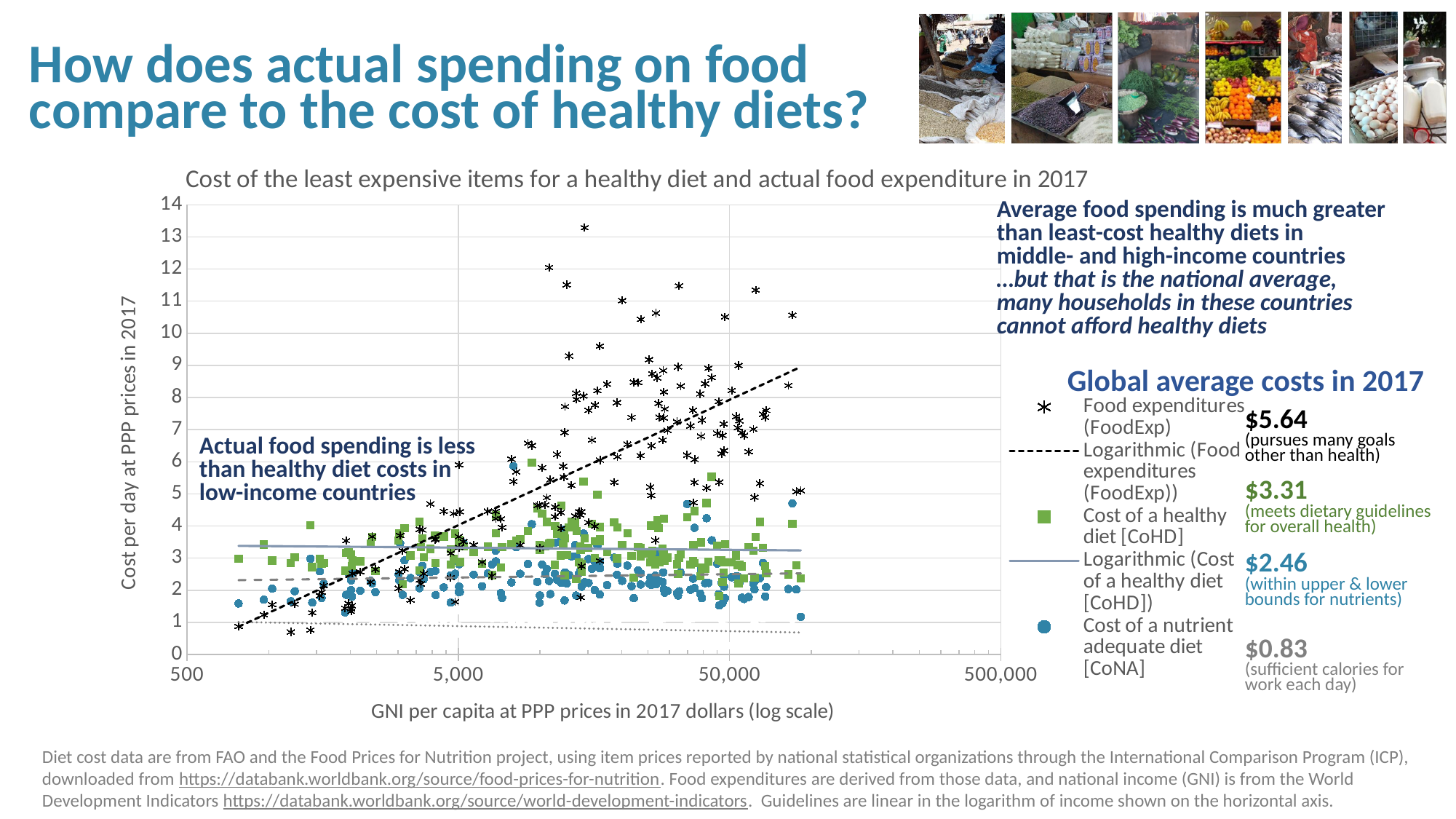
Does the logarithmic trend line for food expenditures rise or fall as GNI per capita increases along the x axis? Rises What is the label of the chart's x axis? GNI per capita at PPP prices in 2017 dollars (log scale) Which of the global average costs in 2017 is the highest? Food expenditures (FoodExp), $5.64 What is the global average cost of a healthy diet [CoHD] in 2017? $3.31 What is the difference between the global average food expenditure ($5.64) and the global average cost of a healthy diet ($3.31)? $2.33 What is the global average cost of a nutrient adequate diet [CoNA] in 2017? $2.46 Which of the global average costs in 2017 is the lowest? $0.83 (sufficient calories for work each day) Which is larger: the global average cost of a healthy diet [CoHD] or the global average cost of a nutrient adequate diet [CoNA]? Cost of a healthy diet [CoHD] What is the global average cost in 2017 of sufficient calories for work each day? $0.83 How many series does the chart legend list? 5 What is the global average cost in 2017 for food expenditures (FoodExp)? $5.64 What kind of chart is shown on the slide? Scatter chart